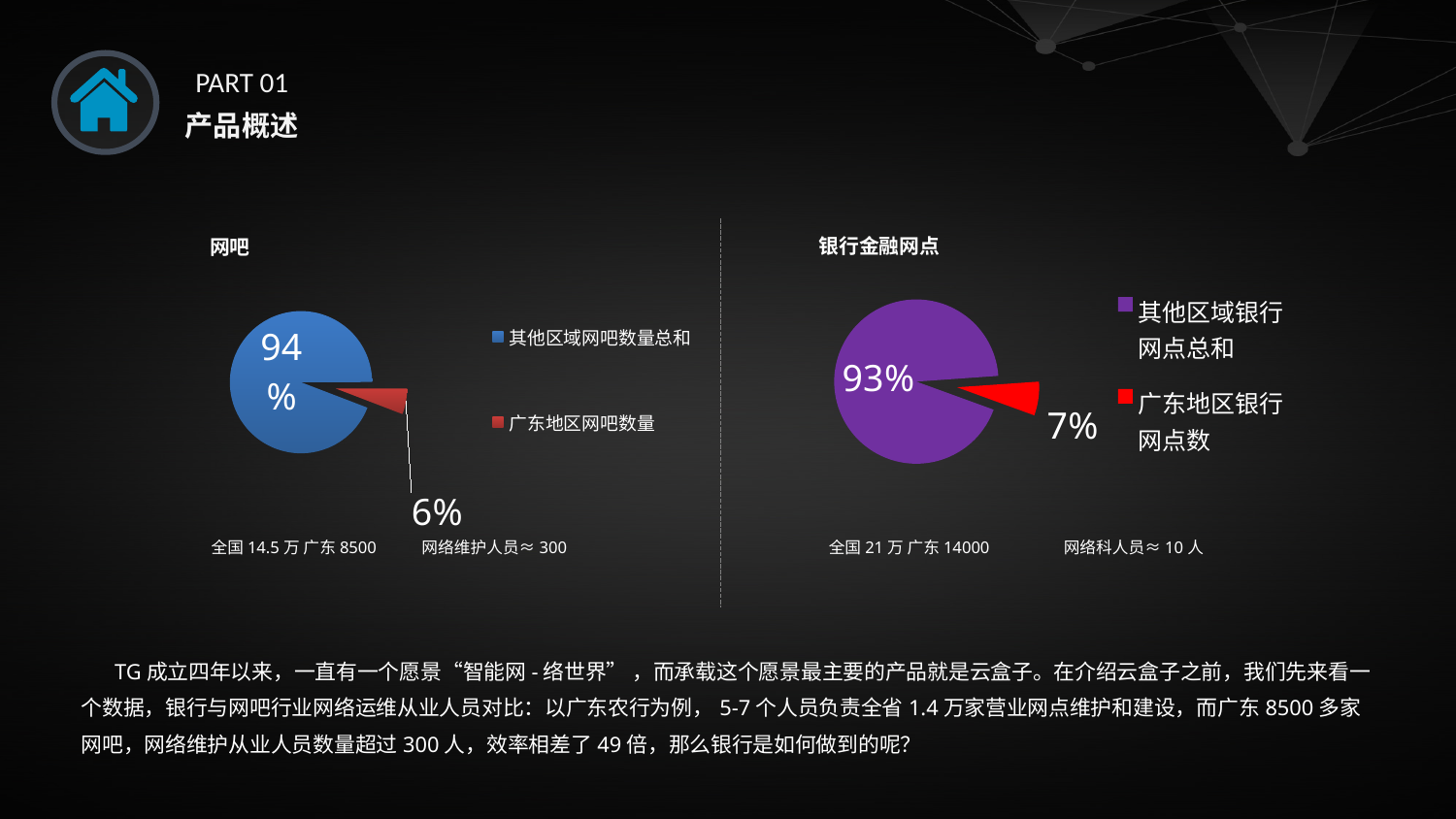
How many slices does the 银行金融网点 chart have? 2 In the 网吧 chart, what share does 广东地区网吧数量 have? 6% In the 银行金融网点 chart, what share does 广东地区银行网点数 have? 7% What kind of chart is the 银行金融网点 chart? Pie chart In the 网吧 chart, what colour is the 广东地区网吧数量 slice? Red In the 网吧 chart, what share does 其他区域网吧数量总和 have? 94% In the 网吧 chart, which slice is the largest? 其他区域网吧数量总和 What kind of chart is the 网吧 chart? Pie chart In the 网吧 chart, what is the difference between the 其他区域网吧数量总和 share and the 广东地区网吧数量 share? 88% Which is larger: the 广东地区网吧数量 share in the 网吧 chart or the 广东地区银行网点数 share in the 银行金融网点 chart? 广东地区银行网点数 (7%) In the 银行金融网点 chart, which slice is the smallest? 广东地区银行网点数